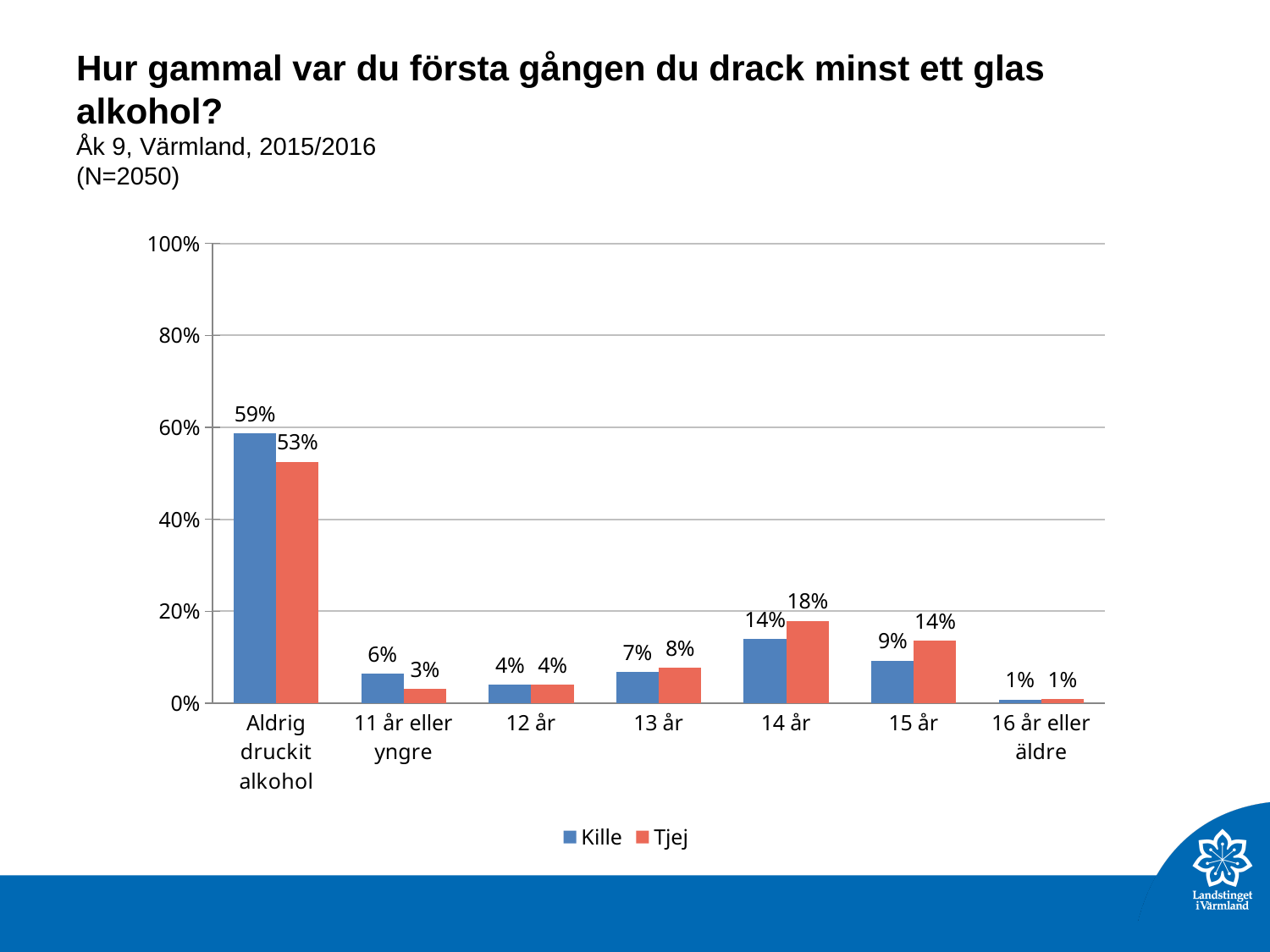
How many categories are shown on the x axis? 7 How many series does the legend list? 2 What kind of chart is shown on the slide? Bar chart Which category has the lowest value for Kille? 16 år eller äldre In the "14 år" category, which series has the larger value, Kille or Tjej? Tjej What is the value for Kille in the "Aldrig druckit alkohol" category? 59% What is the difference between Tjej and Kille in the "15 år" category? 5% What is the difference between Kille and Tjej in the "Aldrig druckit alkohol" category? 6% What is the value for Tjej in the "14 år" category? 18% Is the value for Tjej in the "Aldrig druckit alkohol" category greater or less than 40%? greater What is the value for Tjej in the "11 år eller yngre" category? 3% Which category has the highest value for Tjej? Aldrig druckit alkohol